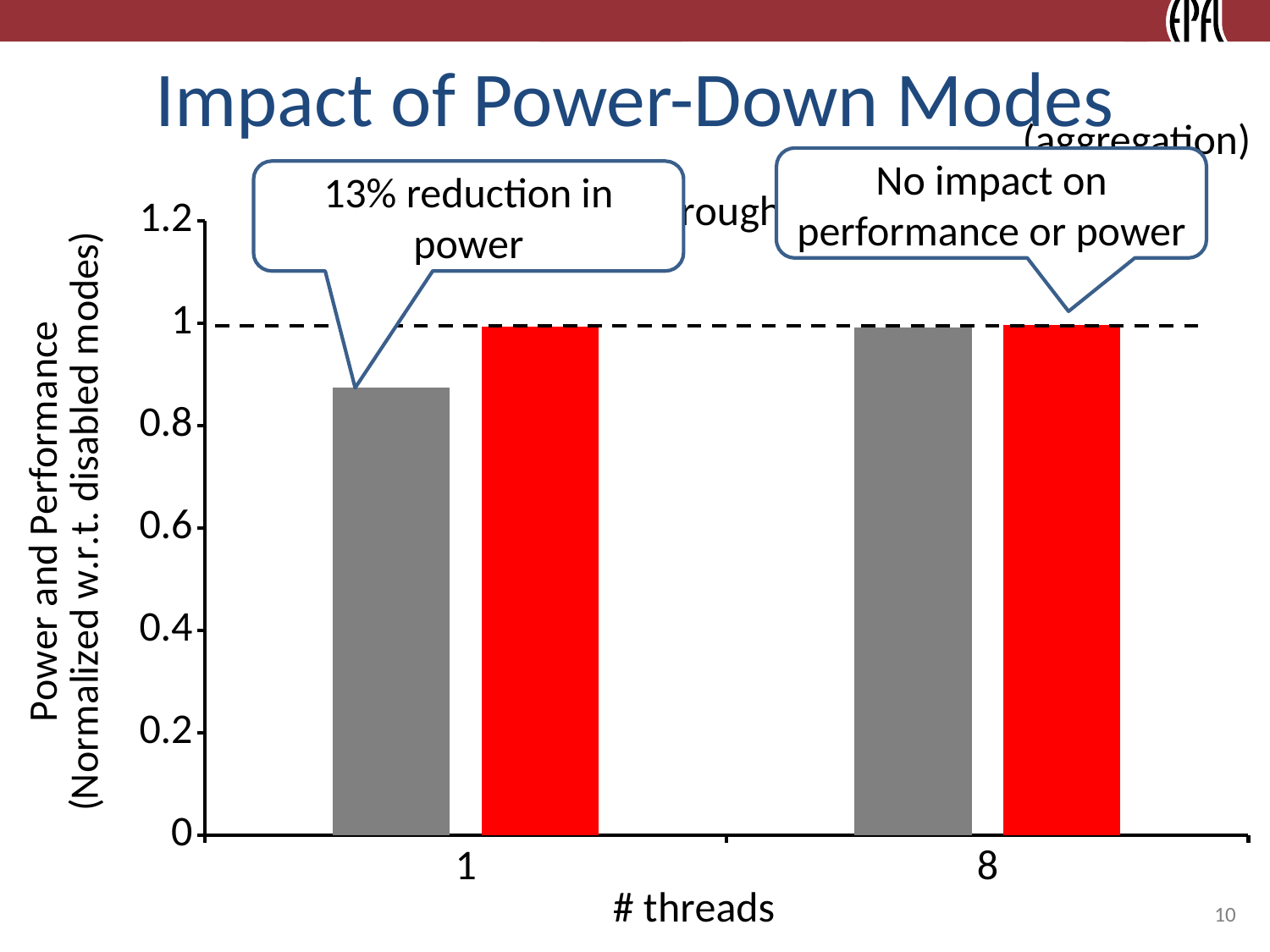
Is the value of the red bar for 1 thread greater or less than 1.2? less Is the value of the gray bar for 1 thread greater or less than 1? less Is the value of the red bar for 8 threads greater or less than 0.8? greater Does the gray bar rise or fall from 1 thread to 8 threads? rise What is the label of the x axis? # threads Which bar in the chart is the lowest? the gray bar for 1 thread How many categories are shown on the x axis of the chart? 2 What kind of chart is shown on the slide? bar chart At what y-axis value is the horizontal dashed line drawn? 1 What is the label of the y axis? Power and Performance (Normalized w.r.t. disabled modes) For 1 thread, which bar is taller, the gray bar or the red bar? the red bar